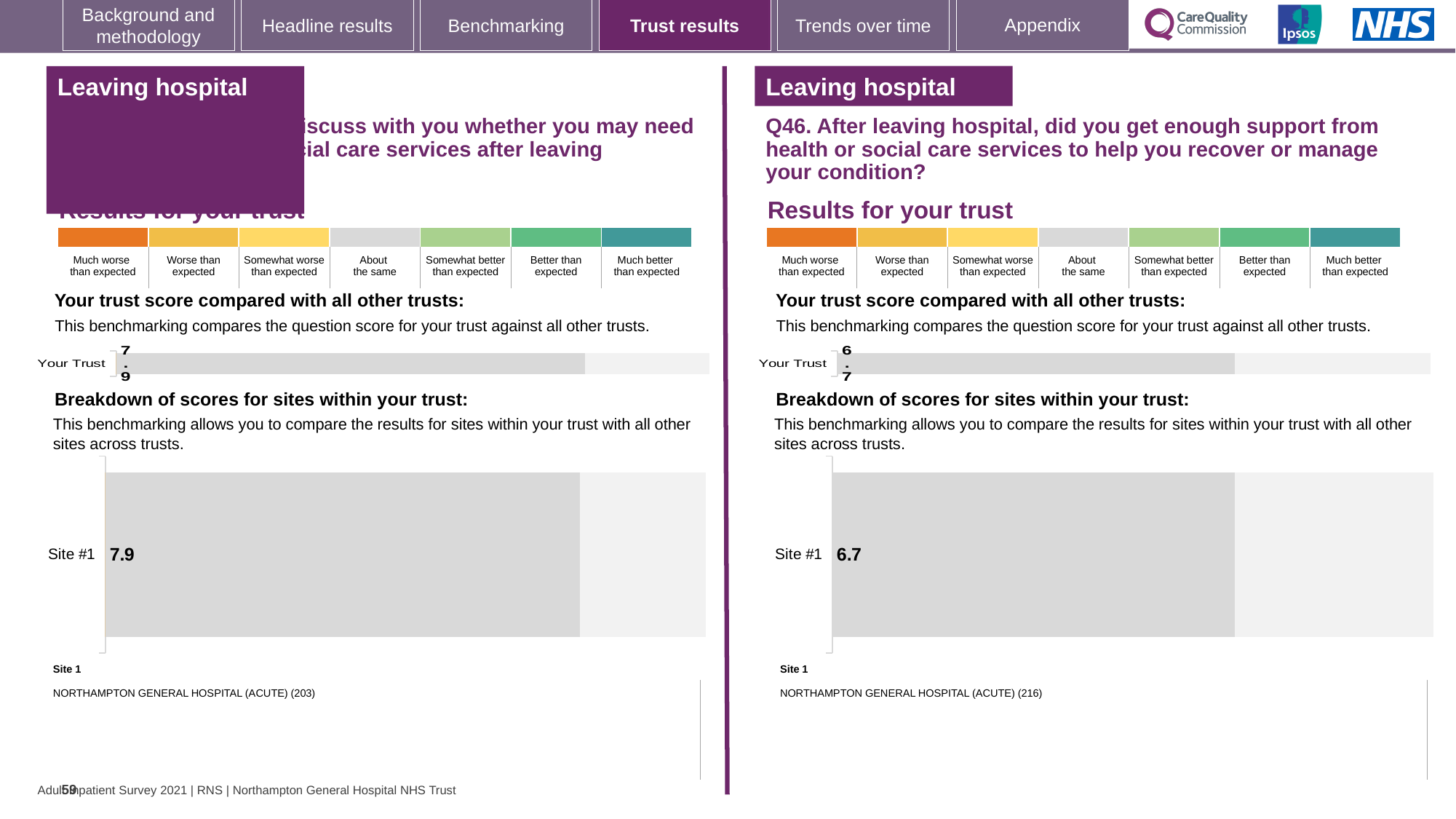
On the right-hand (Q46) 'Breakdown of scores for sites within your trust' chart, what is the score for Site #1? 6.7 What is the difference between the Your Trust score on the left-hand chart and the Your Trust score on the right-hand (Q46) chart? 1.2 What is the difference between the Site #1 score on the left-hand breakdown chart and the Site #1 score on the right-hand (Q46) breakdown chart? 1.2 On the right-hand (Q46) 'Your trust score compared with all other trusts' chart, what is the score for Your Trust? 6.7 How many bars are plotted on the right-hand (Q46) 'Your trust score compared with all other trusts' chart? 1 Which side's 'Breakdown of scores for sites within your trust' chart shows the higher Site #1 score, the left-hand chart or the right-hand (Q46) chart? The left-hand chart Which trust score is higher: Your Trust on the left-hand chart or Your Trust on the right-hand (Q46) chart? Your Trust on the left-hand chart On the left-hand 'Breakdown of scores for sites within your trust' chart, what is the score for Site #1? 7.9 How many sites are shown on the left-hand 'Breakdown of scores for sites within your trust' chart? 1 According to the site key below the right-hand (Q46) breakdown chart, which hospital is Site 1? NORTHAMPTON GENERAL HOSPITAL (ACUTE) What kind of chart is used for the 'Breakdown of scores for sites within your trust' on the right-hand side? Bar chart On the left-hand 'Your trust score compared with all other trusts' chart, what is the score for Your Trust? 7.9